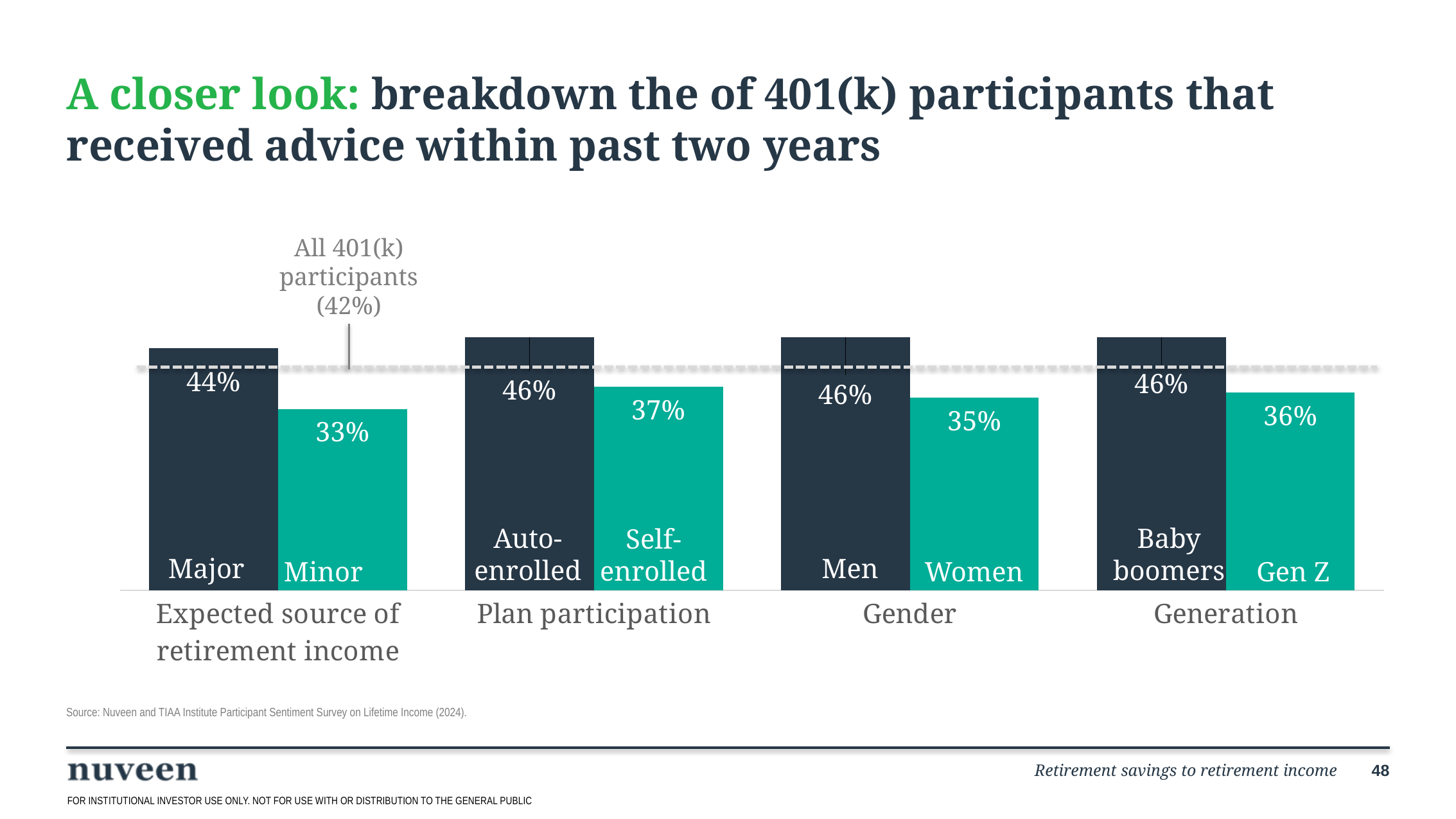
What is the value shown for Women? 35% What is the difference between the values for Men and Women? 11% What is the value shown for Self-enrolled participants? 37% What is the value shown for Gen Z? 36% What kind of chart is shown on the slide? Bar chart How many bars are plotted on the chart? 8 What percentage of 401(k) participants who expect their 401(k) to be a major source of retirement income received advice within the past two years? 44% What is the difference between the values for Auto-enrolled and Self-enrolled participants? 9% How many category groups are labelled along the x axis? 4 Which is larger, the value for Baby boomers or the value for Gen Z? Baby boomers What percentage is shown for all 401(k) participants by the dashed reference line? 42% Which bar has the lowest value on the chart? Minor